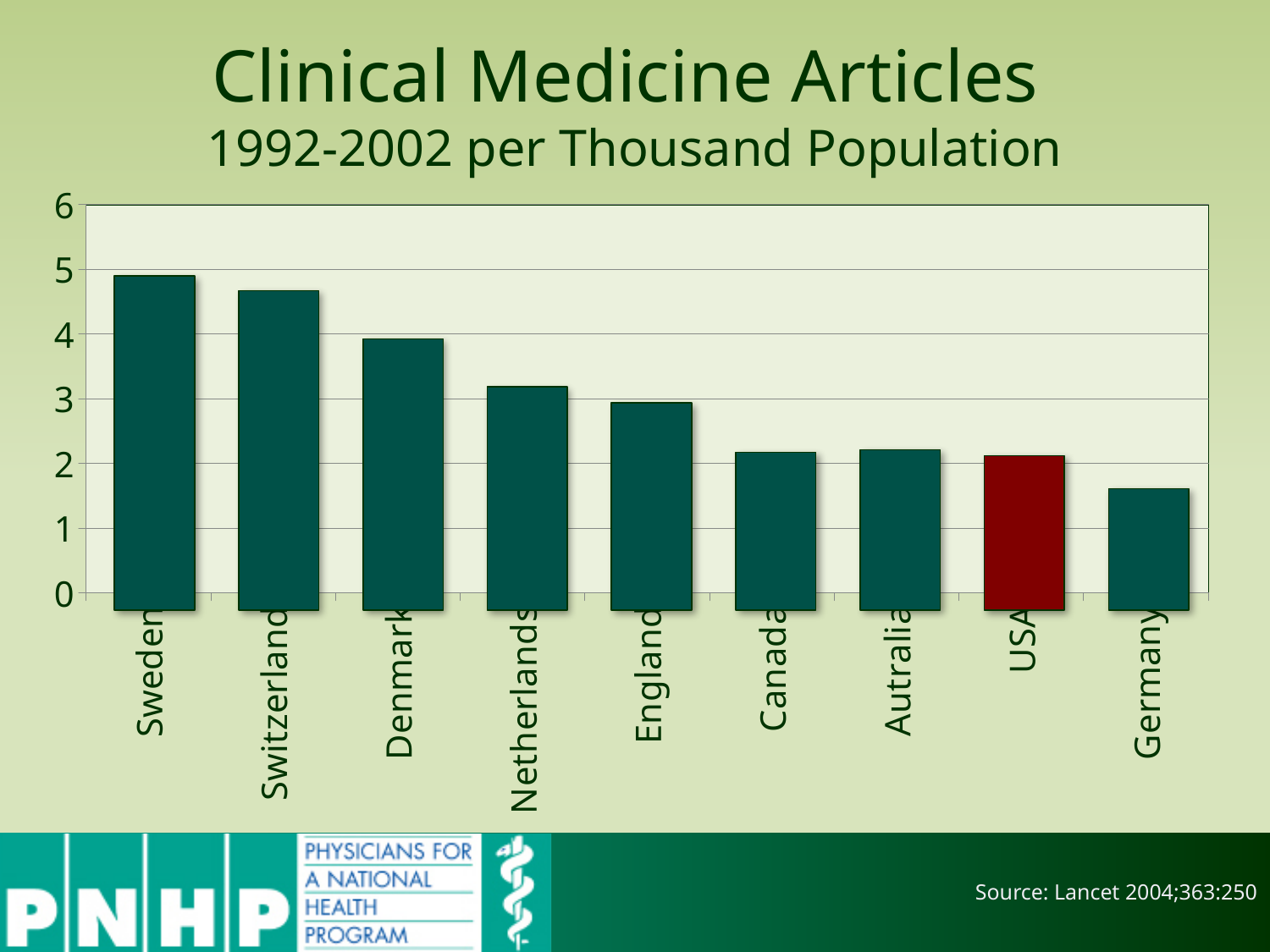
Is the value for Netherlands greater or less than 3? greater Which country has the lowest value for clinical medicine articles per thousand population? Germany Which country's bar is coloured red instead of dark green? USA How many countries are shown in the chart? 9 Which has a higher value, Denmark or England? Denmark Is the value for Sweden greater or less than 4? greater What kind of chart is shown on the slide? bar chart Is the value for Switzerland greater or less than 4? greater What is the title of the chart? Clinical Medicine Articles 1992-2002 per Thousand Population Which country has the highest value for clinical medicine articles per thousand population? Sweden Do the values rise or fall moving from left to right along the x axis? fall